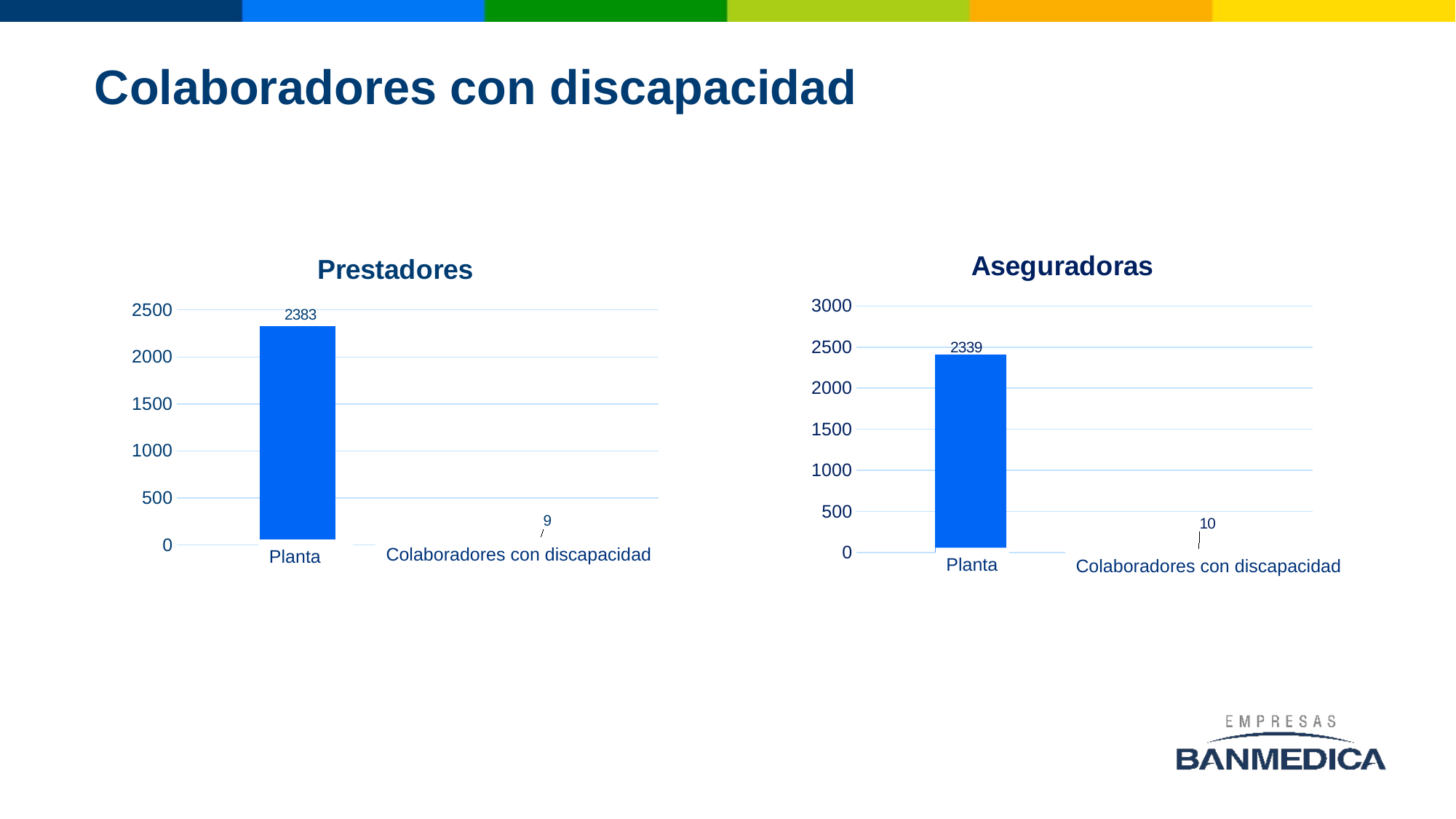
How many categories does the Prestadores chart show? 2 In the Aseguradoras chart, which category has the lowest value? Colaboradores con discapacidad In the Prestadores chart, what is the value for Colaboradores con discapacidad? 9 In the Aseguradoras chart, what is the difference between the Planta value and the Colaboradores con discapacidad value? 2329 In the Prestadores chart, what is the difference between the Planta value and the Colaboradores con discapacidad value? 2374 In the Aseguradoras chart, what is the value for Colaboradores con discapacidad? 10 In the Aseguradoras chart, what is the value for Planta? 2339 In the Prestadores chart, what is the value for Planta? 2383 Which is larger: the Planta value in the Prestadores chart or the Planta value in the Aseguradoras chart? Prestadores What kind of chart is the Aseguradoras chart? bar chart In the Prestadores chart, which category has the highest value? Planta In the Aseguradoras chart, is the value for Planta greater or less than 2000? greater